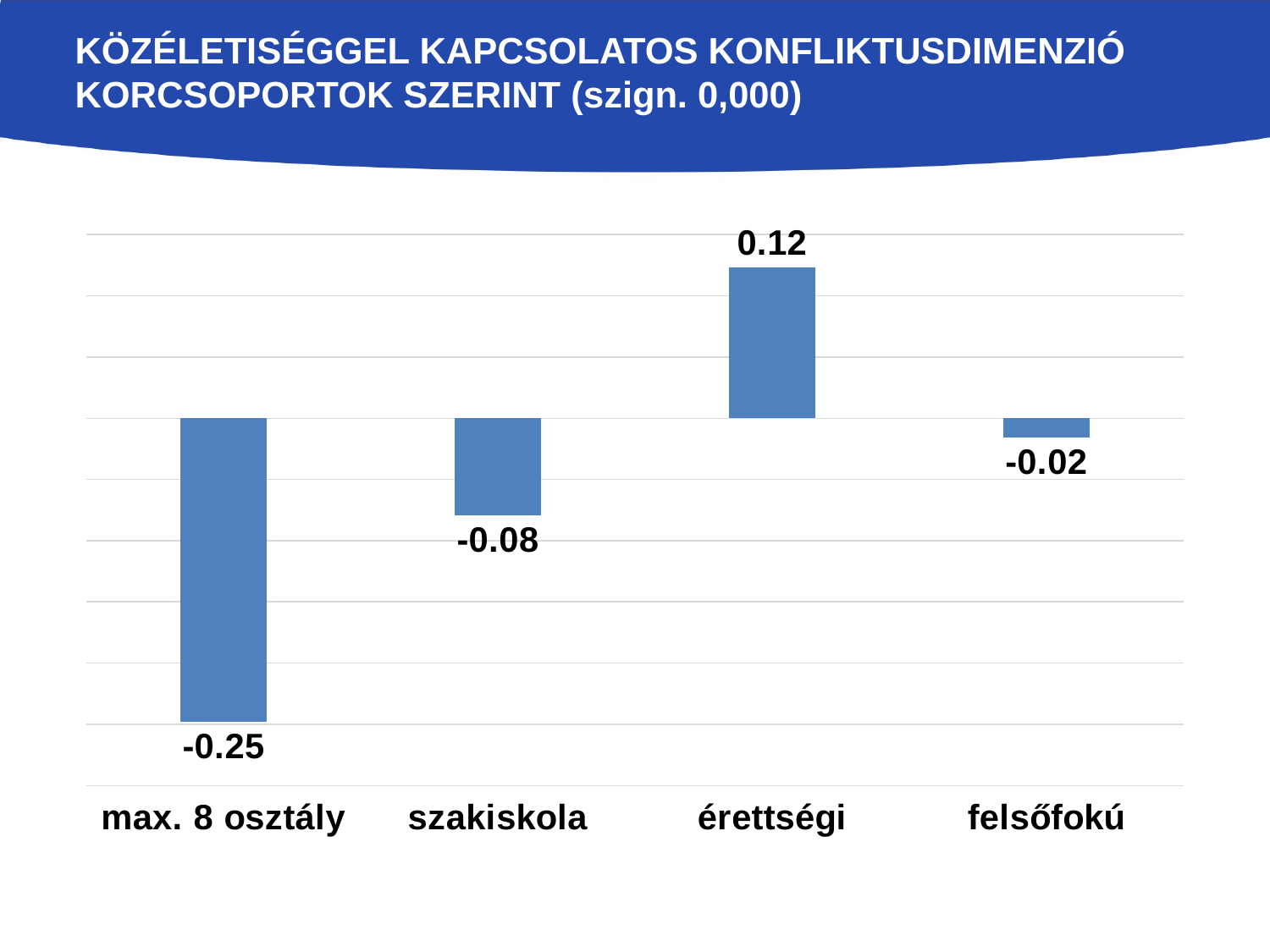
How many categories are shown in the chart? 4 What is the difference between the values for szakiskola and felsőfokú? 0.06 How many categories have a negative value? 3 What is the value for szakiskola? -0.08 Which is larger, the value for szakiskola or the value for felsőfokú? felsőfokú What is the value for max. 8 osztály? -0.25 What is the value for felsőfokú? -0.02 What is the value for érettségi? 0.12 Which category has the lowest value? max. 8 osztály What is the difference between the values for érettségi and max. 8 osztály? 0.37 Which category has the highest value? érettségi What kind of chart is shown on the slide? bar chart